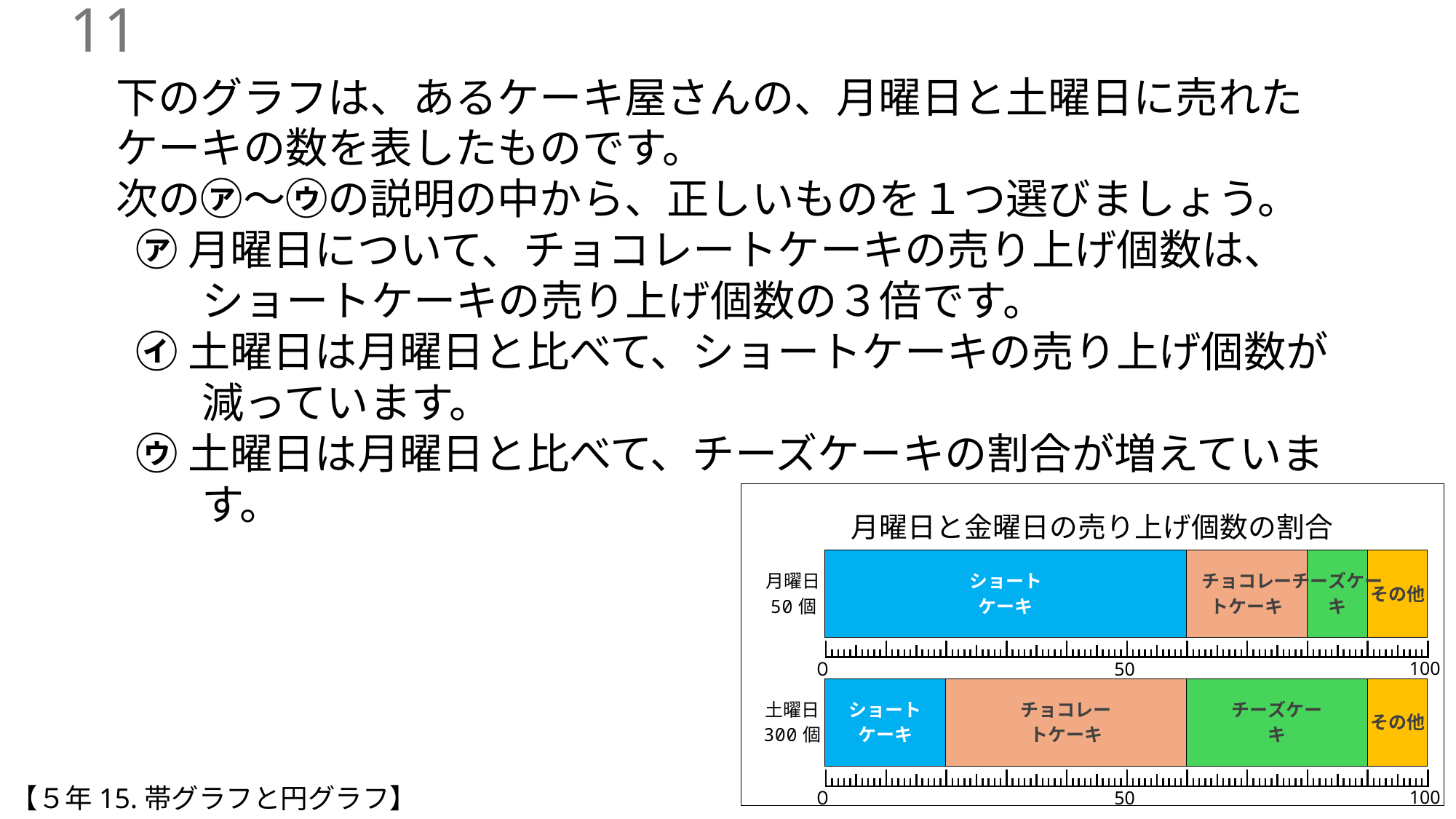
Is the share of ショートケーキ in the 土曜日 bar greater or less than 50? less Which day has the larger share of チーズケーキ, 月曜日 or 土曜日? 土曜日 What total number of cakes is labelled for 月曜日? 50個 Is the share of ショートケーキ in the 月曜日 bar greater or less than 50? greater What is the title of the chart? 月曜日と金曜日の売り上げ個数の割合 How many bars (days) does the chart show? 2 Which cake category has the largest share in the 月曜日 bar? ショートケーキ How many cake categories (segments) are shown in each bar? 4 Which cake category has the largest share in the 土曜日 bar? チョコレートケーキ What total number of cakes is labelled for 土曜日? 300個 What kind of chart is shown on the slide? Stacked bar chart Which cake category has the smallest share in the 土曜日 bar? その他